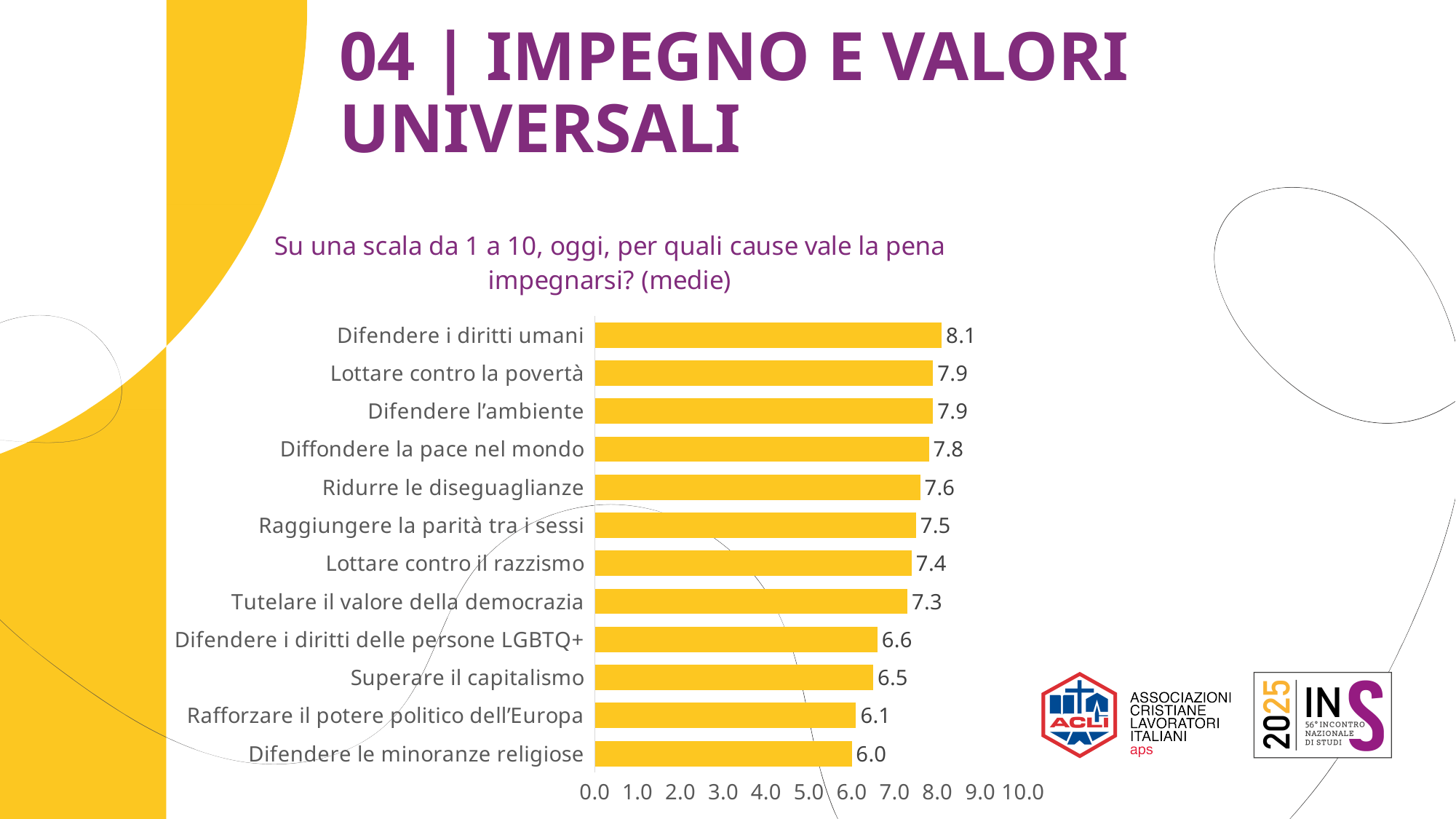
What kind of chart is shown on the slide? Bar chart Which category has the lowest value? Difendere le minoranze religiose What is the title of the chart? Su una scala da 1 a 10, oggi, per quali cause vale la pena impegnarsi? (medie) What is the difference between the values for "Diffondere la pace nel mondo" and "Rafforzare il potere politico dell'Europa"? 1.7 What is the value for "Difendere i diritti umani"? 8.1 Which category has the highest value? Difendere i diritti umani How many categories are shown in the chart? 12 What is the value for "Superare il capitalismo"? 6.5 Which is larger, the value for "Lottare contro il razzismo" or the value for "Difendere i diritti delle persone LGBTQ+"? Lottare contro il razzismo What is the difference between the values for "Difendere i diritti umani" and "Difendere le minoranze religiose"? 2.1 What is the value for "Tutelare il valore della democrazia"? 7.3 What colour are the bars in the chart? Yellow